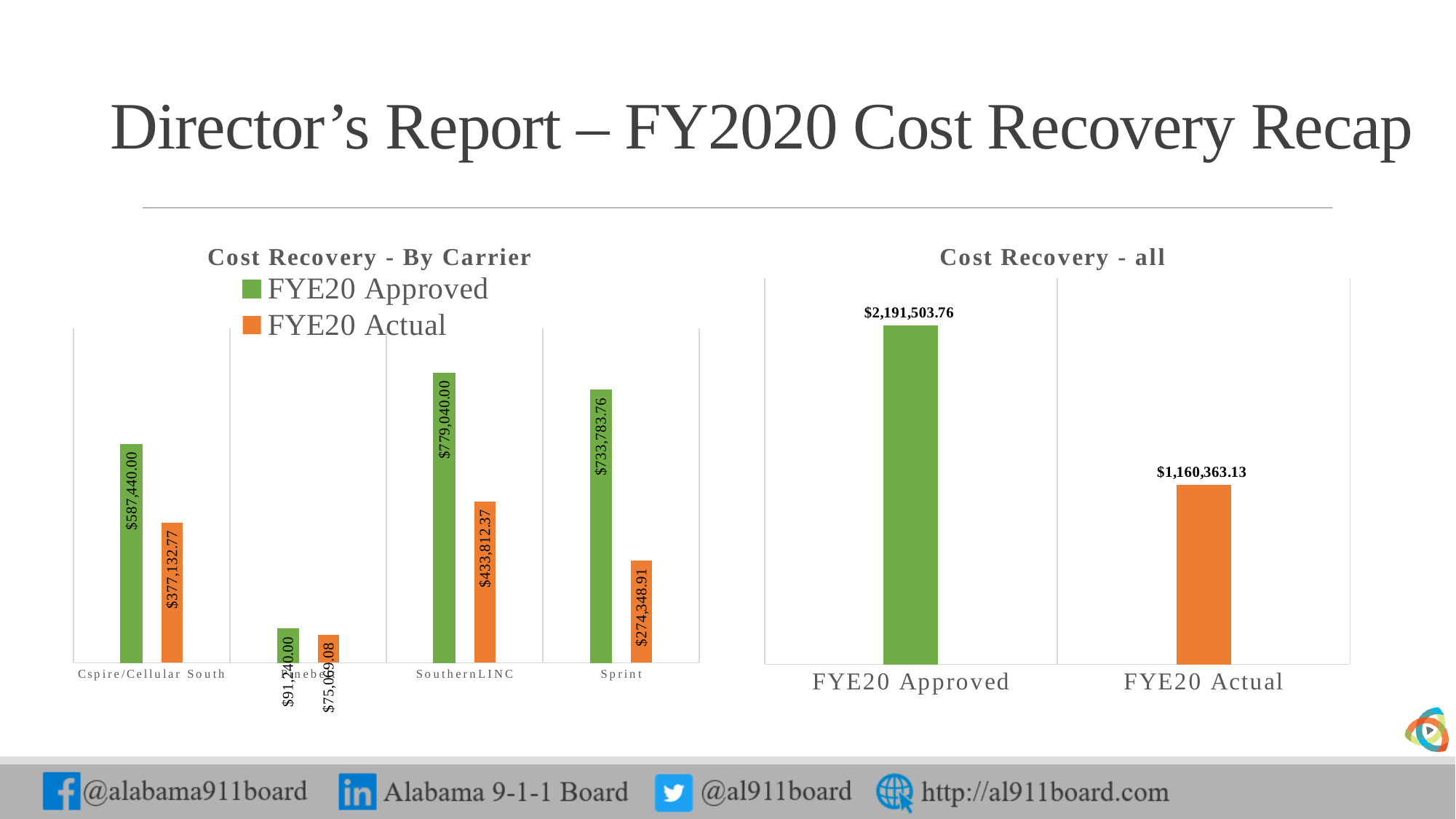
In the 'Cost Recovery - By Carrier' chart, what is the FYE20 Actual value for Cspire/Cellular South? $377,132.77 In the 'Cost Recovery - By Carrier' chart, which carrier has the highest FYE20 Approved value? SouthernLINC In the 'Cost Recovery - By Carrier' chart, which carrier has the highest FYE20 Actual value? SouthernLINC In the 'Cost Recovery - By Carrier' chart, what is the FYE20 Actual value for Sprint? $274,348.91 In the 'Cost Recovery - By Carrier' chart, what is the difference between the FYE20 Approved and FYE20 Actual values for Cspire/Cellular South? $210,307.23 In the 'Cost Recovery - all' chart, what is the difference between FYE20 Approved and FYE20 Actual? $1,031,140.63 In the 'Cost Recovery - By Carrier' chart, what is the FYE20 Approved value for SouthernLINC? $779,040.00 What type of chart is the 'Cost Recovery - all' chart? Bar chart In the 'Cost Recovery - all' chart, what is the value for FYE20 Approved? $2,191,503.76 In the 'Cost Recovery - By Carrier' chart, which is larger: the FYE20 Actual value for SouthernLINC or the FYE20 Actual value for Sprint? SouthernLINC How many carriers are shown in the 'Cost Recovery - By Carrier' chart? 4 How many series does the legend of the 'Cost Recovery - By Carrier' chart list? 2